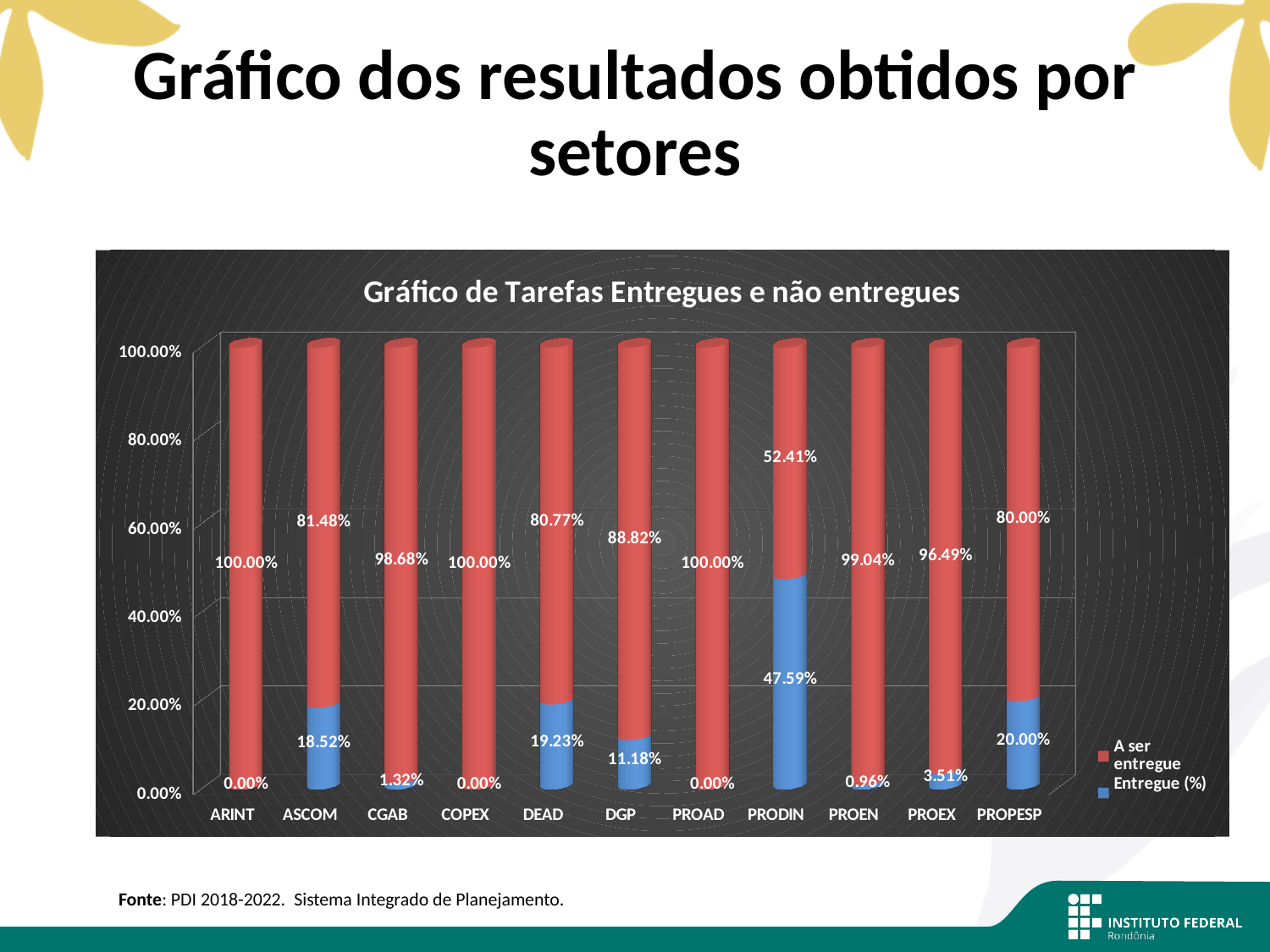
What kind of chart is shown on the slide? Stacked bar chart How many sectors are shown on the x axis of the chart? 11 What is the value of "A ser entregue" for ASCOM? 81.48% What is the difference between the "Entregue (%)" values for PROPESP and DGP? 8.82% What is the value of "Entregue (%)" for DEAD? 19.23% What is the total of the stacked bar for PROEN? 100.00% What is the value of "Entregue (%)" for PRODIN? 47.59% What is the value of "A ser entregue" for PROEX? 96.49% Which sector has the lowest "A ser entregue" value? PRODIN Which is larger, the "Entregue (%)" value for ASCOM or for CGAB? ASCOM Which sector has the highest "Entregue (%)" value? PRODIN How many series does the chart's legend list? 2